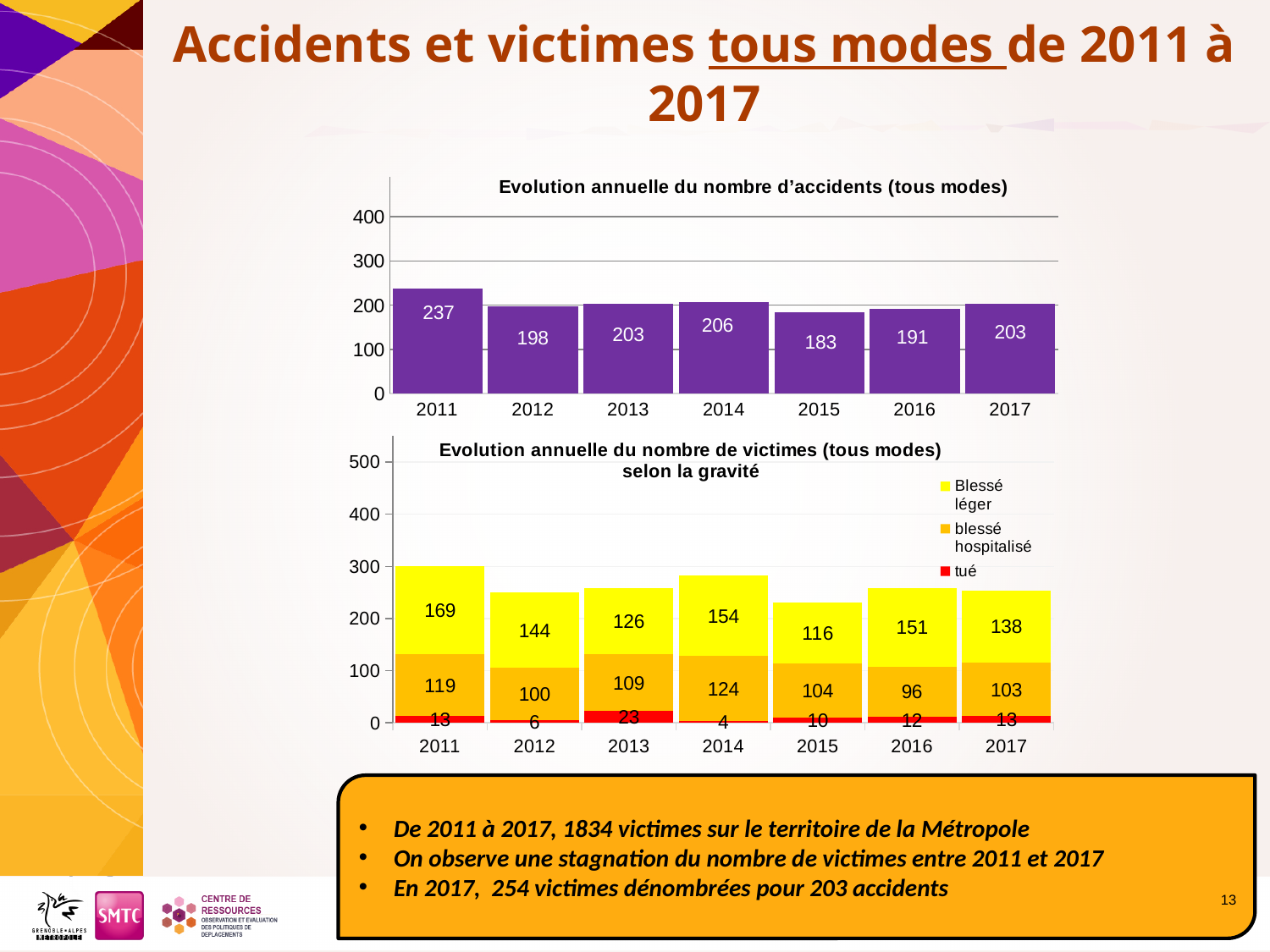
How many series does the legend of the chart 'Evolution annuelle du nombre de victimes (tous modes) selon la gravité' list? 3 In the chart 'Evolution annuelle du nombre de victimes (tous modes) selon la gravité', which year has the lowest value for 'tué'? 2014 In the chart 'Evolution annuelle du nombre de victimes (tous modes) selon la gravité', what is the value for 'tué' in 2013? 23 In the chart 'Evolution annuelle du nombre d'accidents (tous modes)', what is the difference between the values for 2011 and 2015? 54 In the chart 'Evolution annuelle du nombre d'accidents (tous modes)', how many years are shown on the x axis? 7 In the chart 'Evolution annuelle du nombre de victimes (tous modes) selon la gravité', what is the total of the stacked bar for 2017? 254 In the chart 'Evolution annuelle du nombre de victimes (tous modes) selon la gravité', what is the value for 'Blessé léger' in 2014? 154 In the chart 'Evolution annuelle du nombre d'accidents (tous modes)', which year has the lowest number of accidents? 2015 In the chart 'Evolution annuelle du nombre de victimes (tous modes) selon la gravité', which is larger: 'blessé hospitalisé' in 2014 or in 2016? 2014 What kind of chart is 'Evolution annuelle du nombre d'accidents (tous modes)'? bar chart In the chart 'Evolution annuelle du nombre d'accidents (tous modes)', which year has the highest number of accidents? 2011 In the chart 'Evolution annuelle du nombre d'accidents (tous modes)', what is the value for 2011? 237